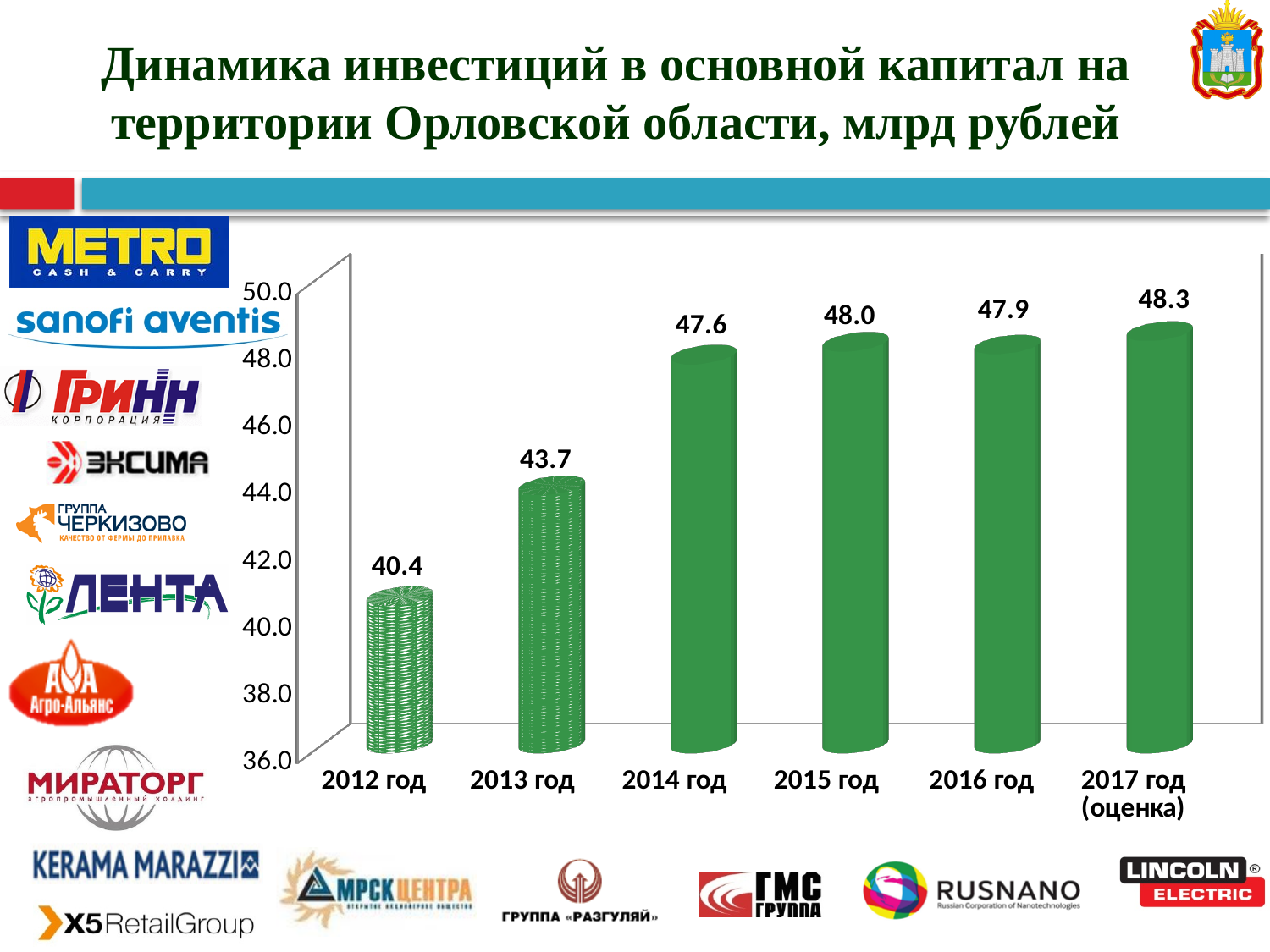
What is the value for 2017 год (оценка)? 48.3 How many years are shown on the chart? 6 Do the values generally rise or fall from 2012 год to 2017 год? rise Which year has the highest value? 2017 год (оценка) Is the value for 2012 год greater or less than 42.0? less What is the value for 2015 год? 48.0 Which is larger, the value for 2013 год or the value for 2014 год? 2014 год What is the value for 2012 год? 40.4 Which year has the lowest value? 2012 год What kind of chart is shown on the slide? bar chart What is the difference between the values for 2014 год and 2013 год? 3.9 What is the difference between the values for 2013 год and 2012 год? 3.3